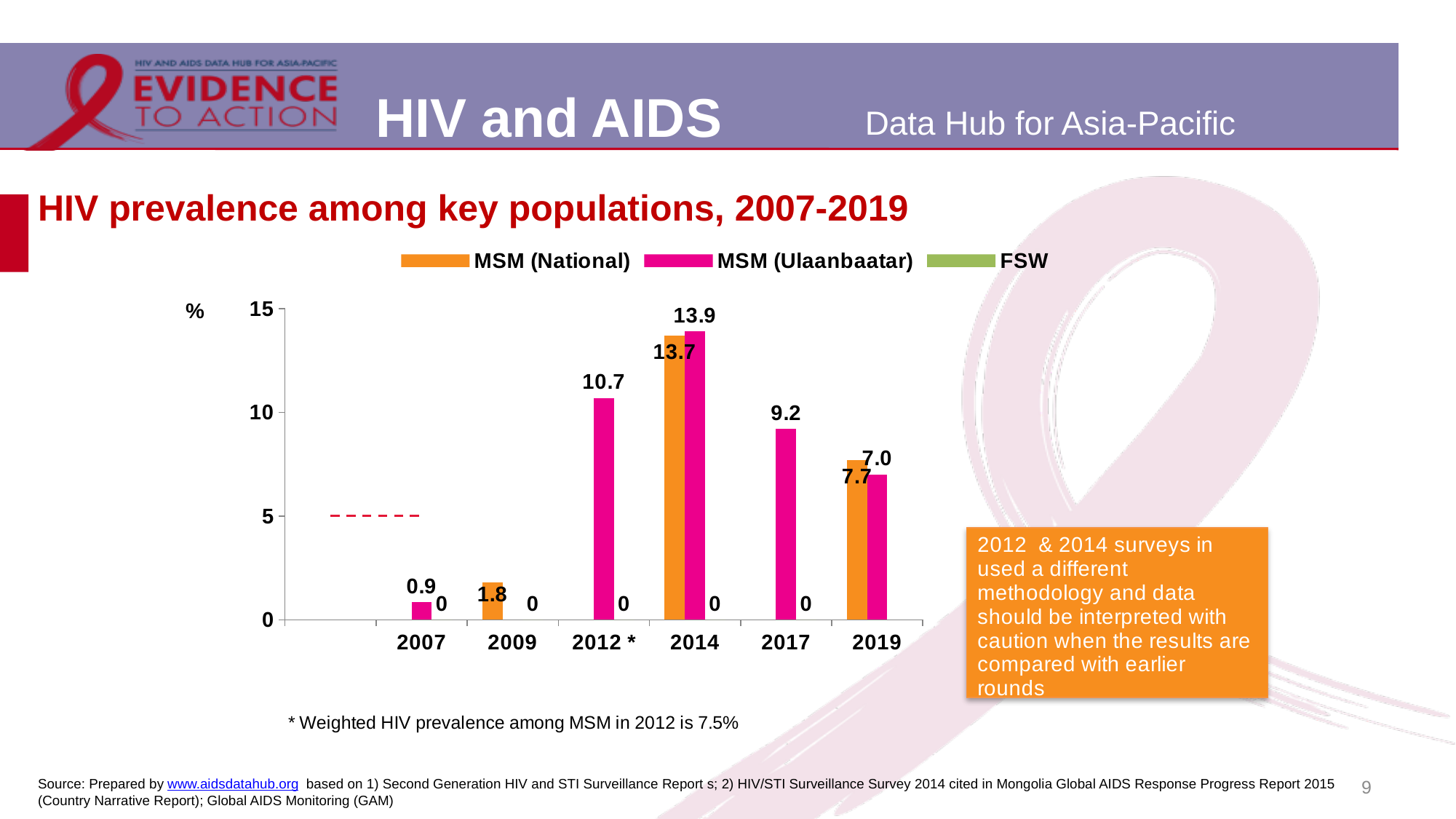
How many series does the legend list? 3 In which year is the MSM (Ulaanbaatar) value lowest? 2007 What is the HIV prevalence for MSM (National) in 2019? 7.7 In which year is the MSM (Ulaanbaatar) value highest? 2014 Which is larger, the MSM (Ulaanbaatar) value in 2012 or in 2017? 2012 Is the MSM (Ulaanbaatar) value for 2017 greater or less than 10? less Does the MSM (Ulaanbaatar) value rise or fall from 2014 to 2019? fall How many years are shown on the x axis? 6 What is the difference between the MSM (Ulaanbaatar) and MSM (National) values in 2014? 0.2 What is the value shown for FSW in 2014? 0 What is the HIV prevalence for MSM (National) in 2009? 1.8 What is the HIV prevalence for MSM (Ulaanbaatar) in 2012? 10.7